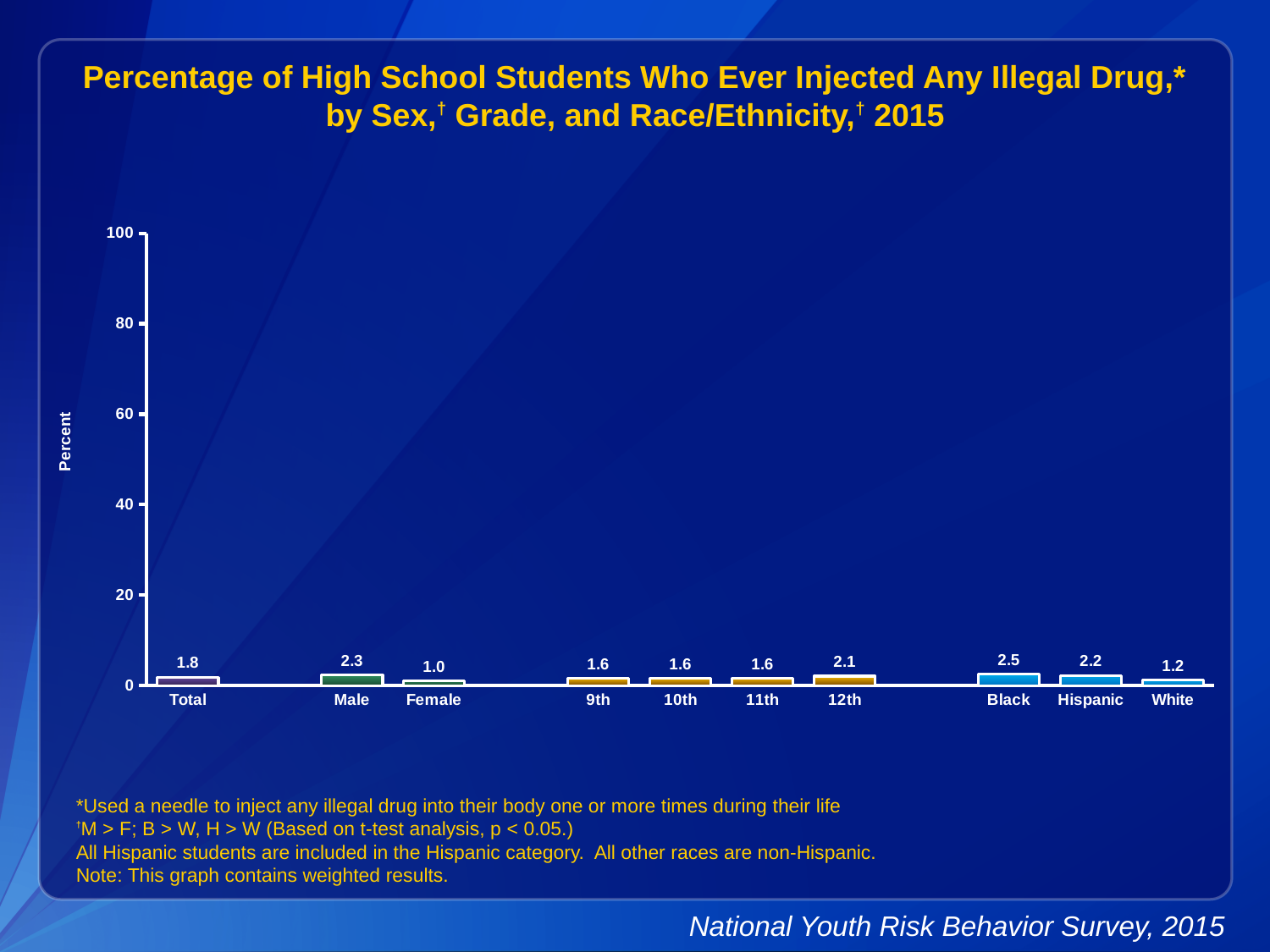
Which category has the lowest value? Female What is the label on the y axis? Percent How many categories are shown on the x axis? 10 What is the difference between the values for Male and Female? 1.3 Which category has the highest value? Black What is the value for Hispanic? 2.2 What kind of chart is shown on the slide? Bar chart What is the value for Total? 1.8 What is the value for 12th grade? 2.1 What is the value for Male? 2.3 What is the value for Female? 1.0 Which is larger, the value for Black or the value for White? Black